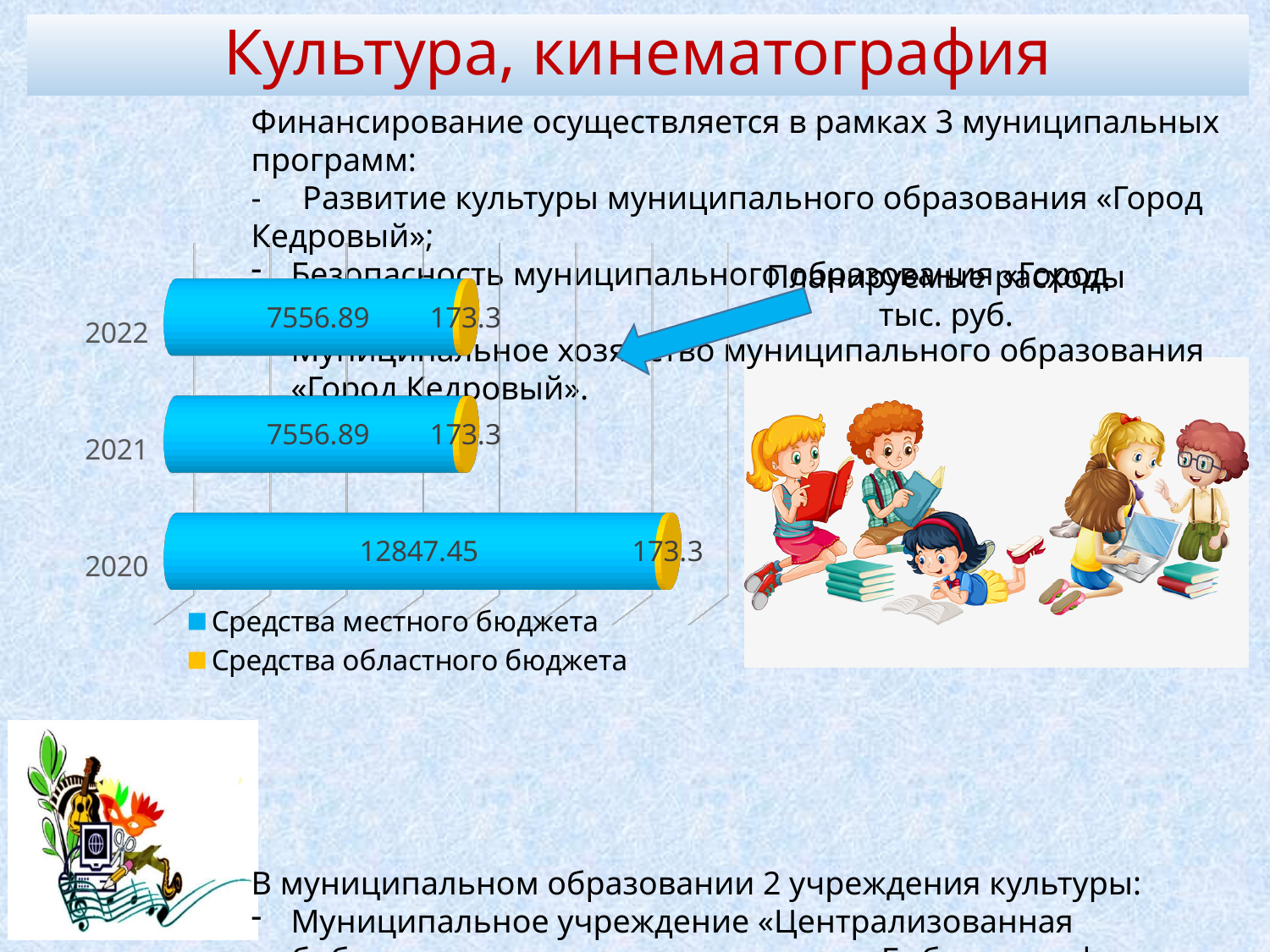
How many years (categories) are shown in the chart? 3 How many series does the chart legend list? 2 What is the value of Средства местного бюджета for 2020? 12847.45 What is the total of the stacked bar for 2022? 7730.19 What is the value of Средства местного бюджета for 2021? 7556.89 Which legend entry is shown in blue? Средства местного бюджета What is the difference between Средства местного бюджета in 2020 and in 2021? 5290.56 What type of chart is shown on the slide? bar chart Which year has the highest value for Средства местного бюджета? 2020 Which is larger: Средства местного бюджета in 2020 or in 2022? 2020 What is the value of Средства областного бюджета for 2022? 173.3 What is the total of the stacked bar for 2020? 13020.75